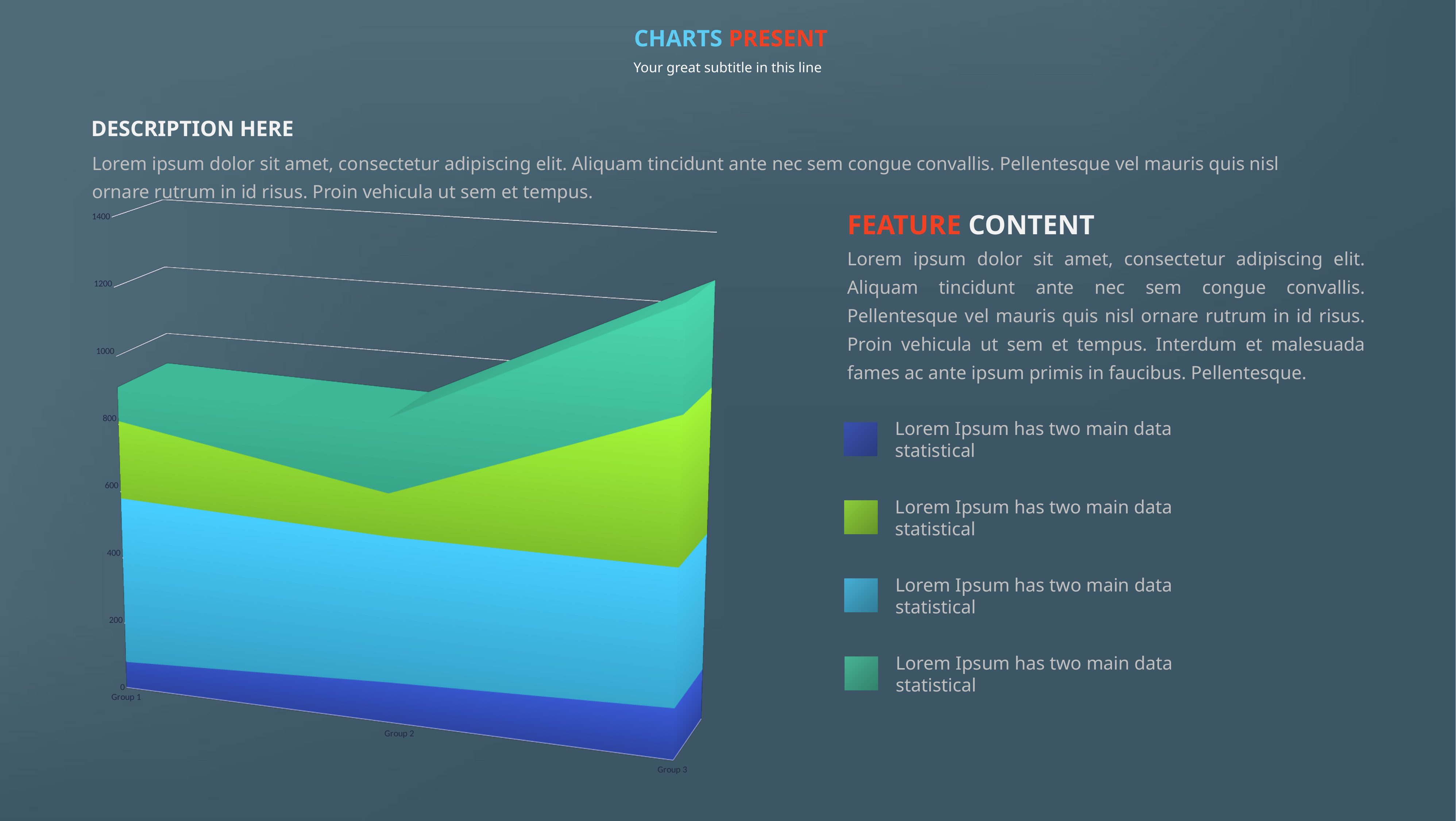
Is the stacked total for Group 1 greater or less than 1000? less Which is larger, the stacked total for Group 3 or for Group 1? Group 3 Which group has the lowest stacked total in the chart? Group 2 How many stacked series are plotted in the chart? 4 Does the stacked total rise or fall from Group 2 to Group 3? rises What colour is the bottom layer of the stacked area chart? Dark blue Is the stacked total for Group 3 greater or less than 1000? greater What is the highest value shown on the vertical axis of the chart? 1400 What kind of chart is shown on the slide? Area chart How many groups are shown along the x axis of the chart? 3 Which group has the highest stacked total in the chart? Group 3